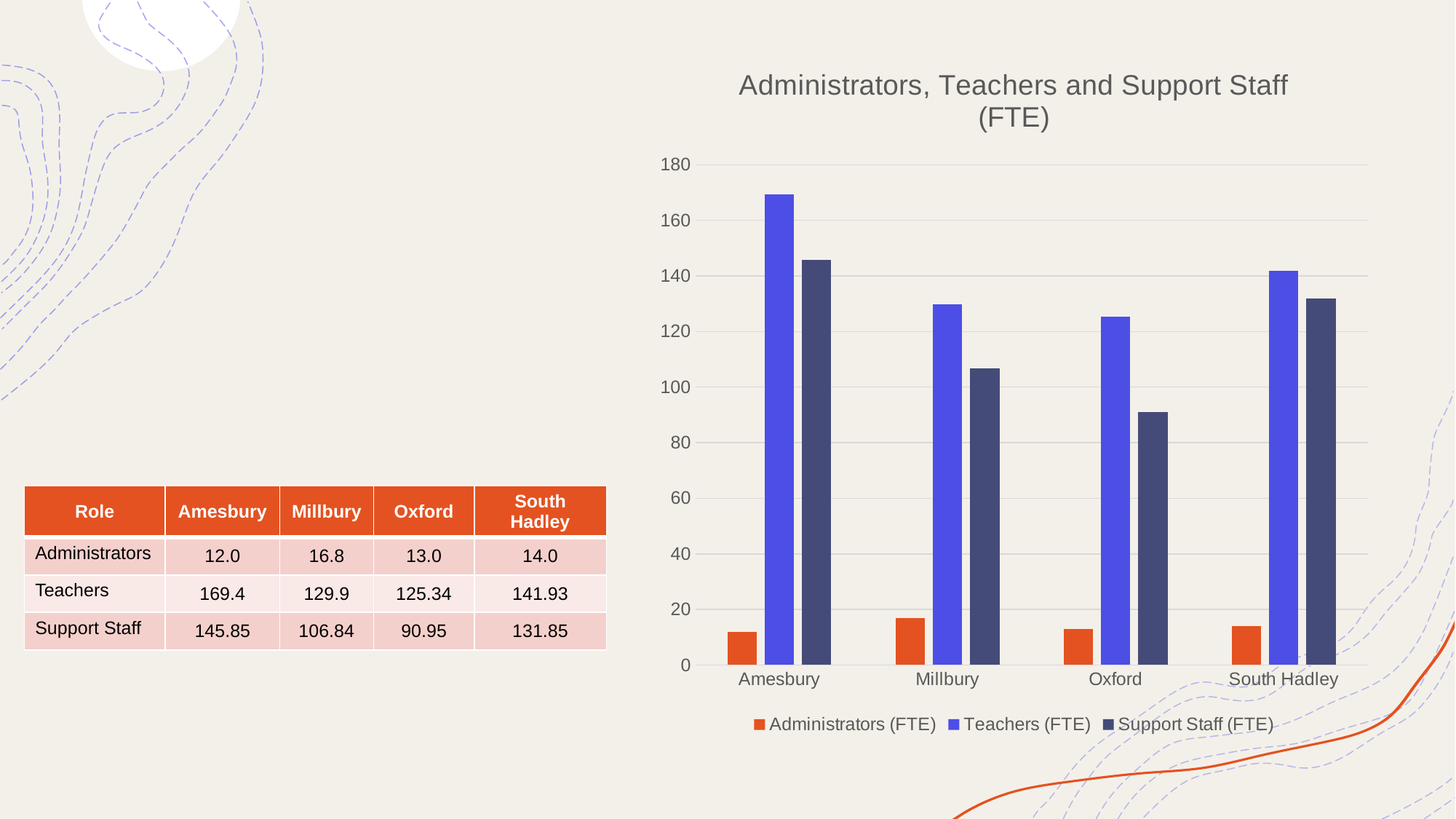
What is the Teachers (FTE) value for Oxford, as printed in the table? 125.34 How many districts are shown on the x axis of the chart? 4 Which district has the highest Administrators (FTE) value? Millbury Is the Teachers (FTE) value for Amesbury greater or less than 160? greater How many series does the chart legend list? 3 Which district has the lowest Support Staff (FTE) value? Oxford What is the Support Staff (FTE) value for Amesbury, as printed in the table? 145.85 What kind of chart is shown on the slide? bar chart What is the title of the chart? Administrators, Teachers and Support Staff (FTE) Which is larger: Support Staff (FTE) for Millbury or Support Staff (FTE) for South Hadley? South Hadley Which district has the highest Teachers (FTE) value? Amesbury Is the Support Staff (FTE) value for Oxford greater or less than 100? less